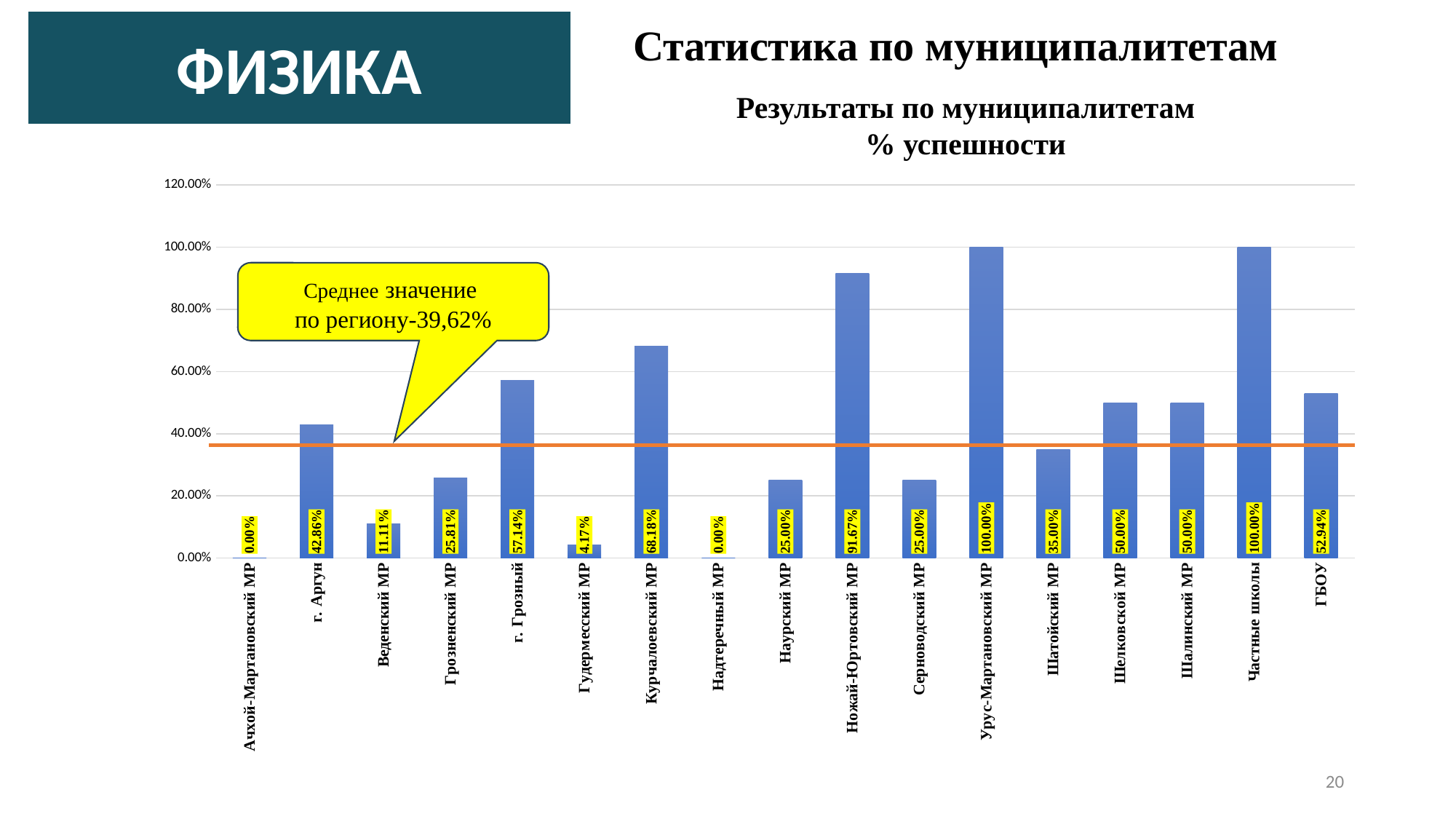
What is the value for Ножай-Юртовский МР? 91.67% How many categories are shown on the x axis? 17 What is the value for г. Грозный? 57.14% Which categories have the lowest value? Ачхой-Мартановский МР and Надтеречный МР Which is larger, the value for Шатойский МР or the value for Грозненский МР? Шатойский МР What is the difference between the values for Курчалоевский МР and г. Аргун? 25.32% What is the value for ГБОУ? 52.94% Which categories have the highest value? Урус-Мартановский МР and Частные школы What kind of chart is shown on the slide? bar chart Is the value for Веденский МР greater or less than 20.00%? less What is the value for Гудермесский МР? 4.17% What regional average value is stated in the callout on the chart? 39,62%